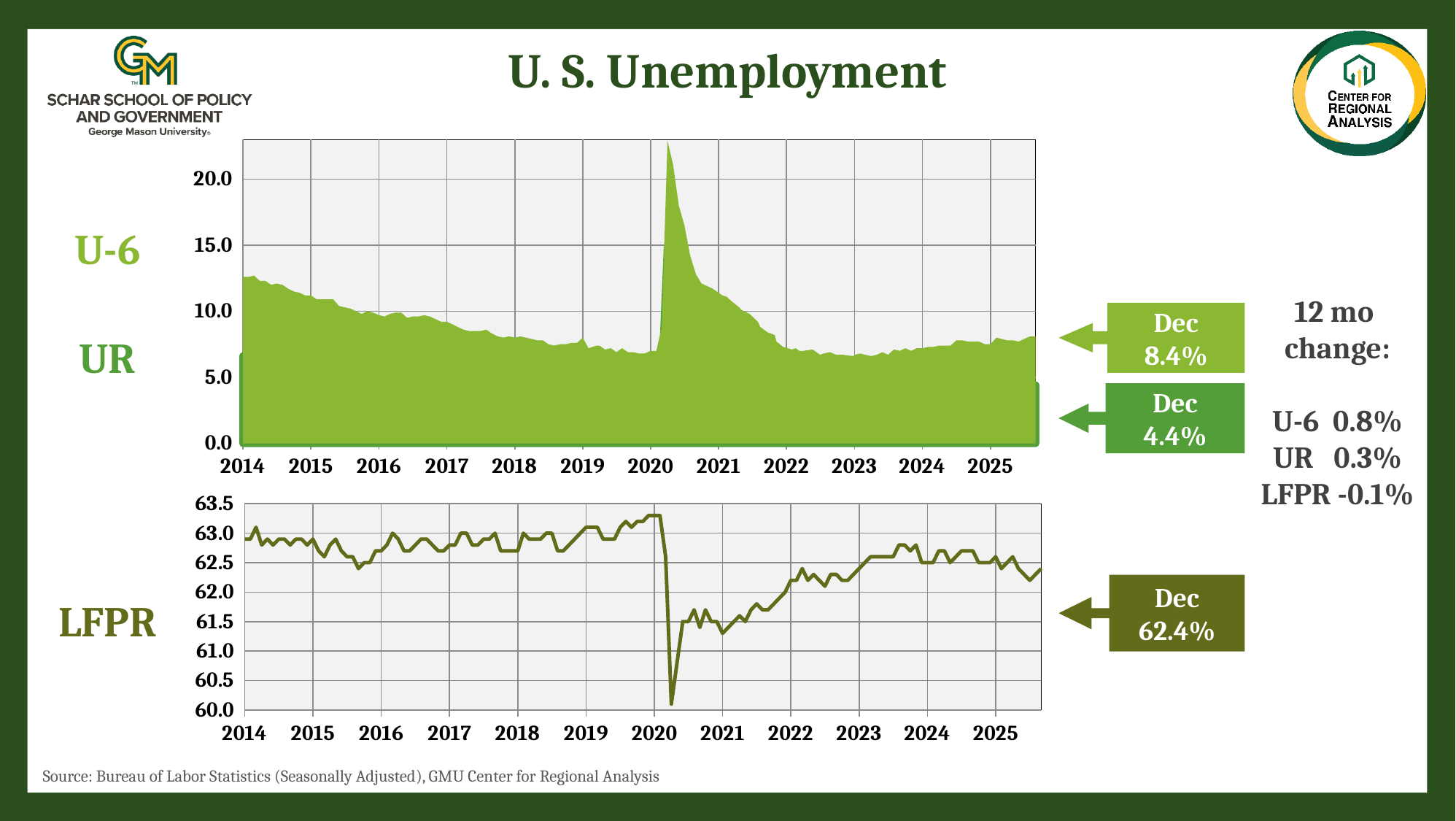
What kind of chart is the bottom LFPR chart? line chart On the top chart, is the peak U-6 value in 2020 greater or less than 20.0? greater On the top chart, does U-6 rise or fall from 2014 to 2019? fall On the top chart, in which year does U-6 reach its highest value? 2020 On the bottom chart, what is the December value shown for LFPR? 62.4% What kind of chart is the top U-6/UR chart? area chart How many year labels are shown on the x axis of the bottom chart? 12 On the top chart, what is the December value shown for UR? 4.4% On the top chart, what is the December value shown for U-6? 8.4% On the bottom chart, is the lowest LFPR value in 2020 greater or less than 60.5? less On the top chart, what is the difference between the December U-6 value and the December UR value? 4.0% On the top chart, which is higher in December, U-6 or UR? U-6